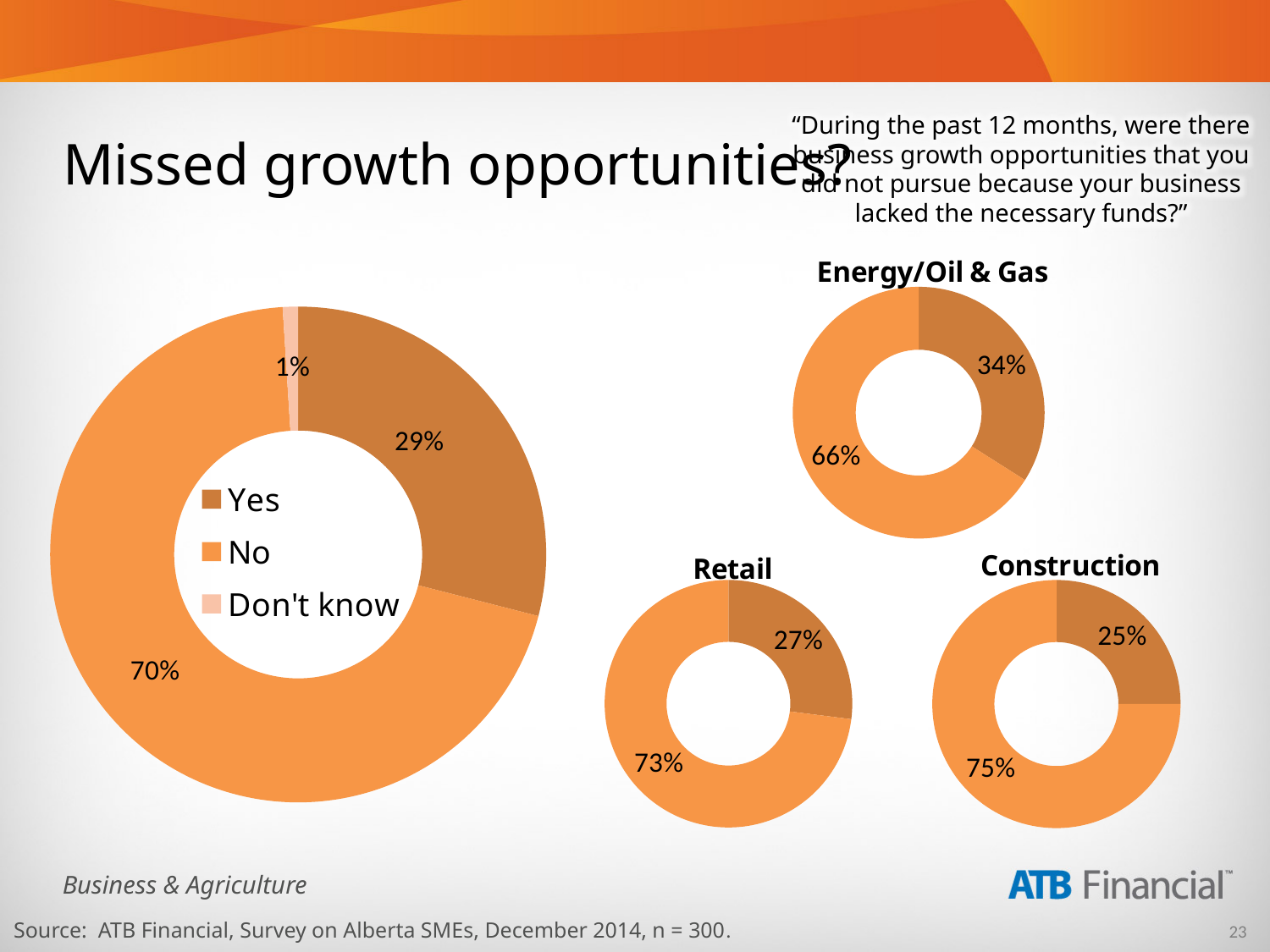
How many entries does the legend of the large doughnut chart on the left list? 3 In the Energy/Oil & Gas chart, what is the smaller of the two percentages shown? 34% In the large doughnut chart on the left, what percentage of respondents answered "Yes"? 29% In the large doughnut chart on the left, which response has the largest share? No In the large doughnut chart on the left, what percentage of respondents answered "Don't know"? 1% In the Retail chart, what is the difference between the two percentages shown (73% and 27%)? 46% In the Energy/Oil & Gas chart, what is the larger of the two percentages shown? 66% What type of chart is used for the Retail data? Doughnut (pie) chart Which chart shows a larger smaller-segment value: Retail (27%) or Construction (25%)? Retail In the large doughnut chart on the left, what percentage of respondents answered "No"? 70% In the large doughnut chart on the left, which response has the smallest share? Don't know In the Construction chart, what is the larger of the two percentages shown? 75%